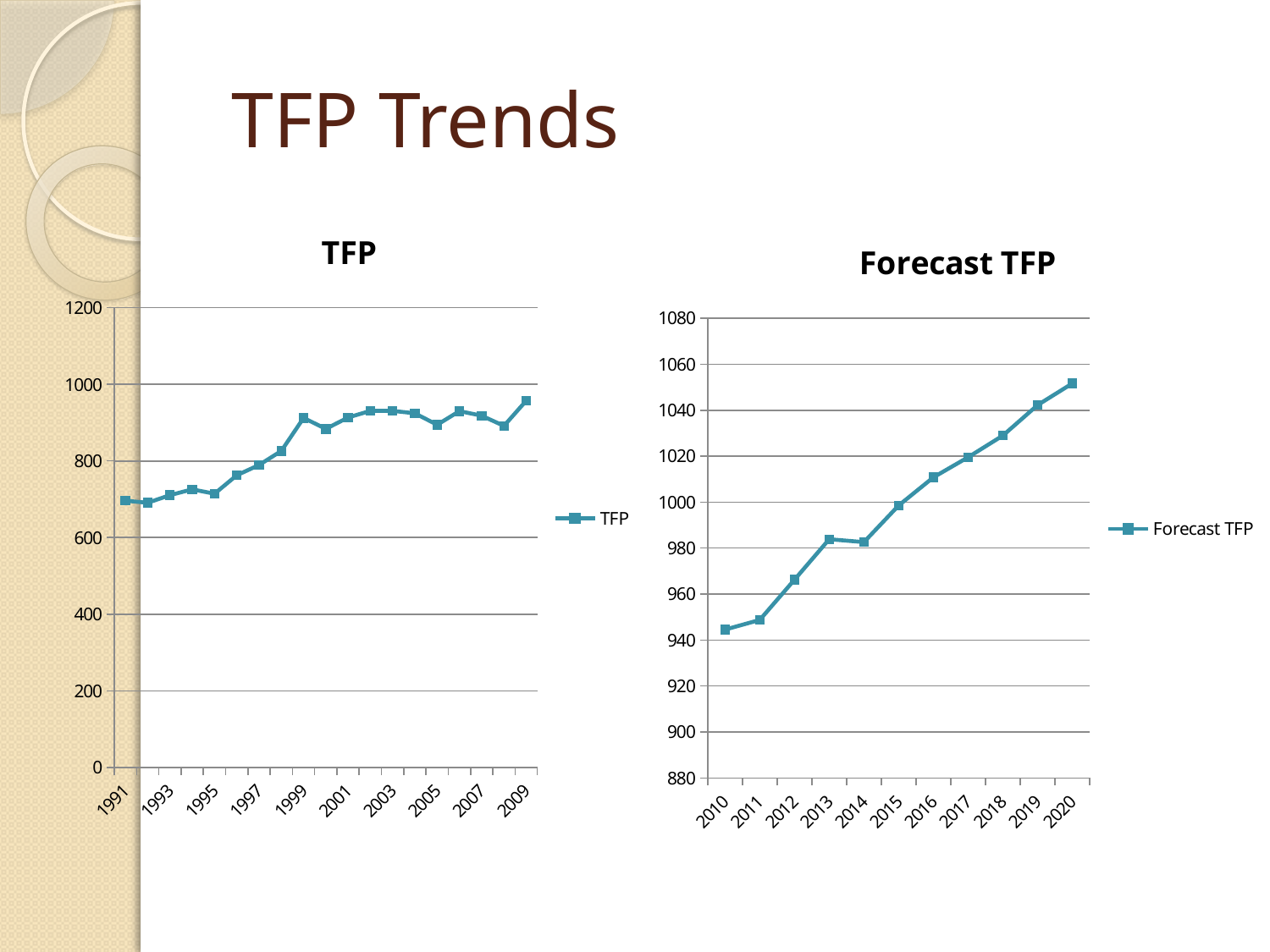
How many years are plotted on the x axis of the 'Forecast TFP' chart? 11 In the 'Forecast TFP' chart, which year has the highest value? 2020 In the 'Forecast TFP' chart, do the values generally rise or fall from 2010 to 2020? Rise In the 'Forecast TFP' chart, is the value for 2020 greater or less than 1040? greater In the 'TFP' chart, is the value for 2009 greater or less than 800? greater How many series does the legend of the 'TFP' chart list? 1 In the 'TFP' chart, is the value for 1991 greater or less than 800? less In the 'TFP' chart, which year has the highest value? 2009 In the 'Forecast TFP' chart, which year has the lowest value? 2010 What kind of chart is the 'TFP' chart on the left of the slide? Line chart